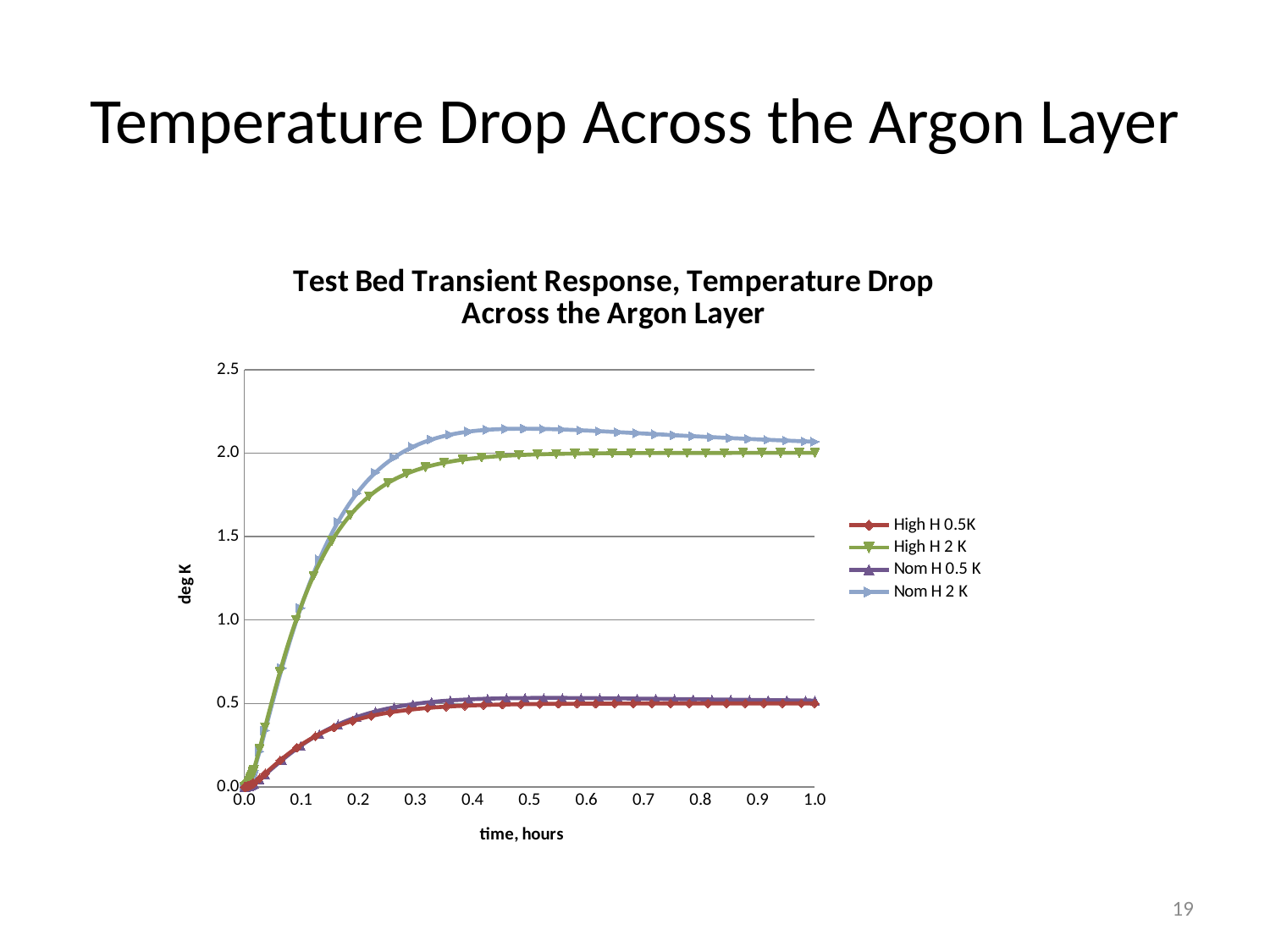
Is the value for Nom H 2 K at 0.1 hours greater or less than 1.5? less Is the value for High H 2 K at 0.2 hours greater or less than 1.5? greater At 0.5 hours, which series has the larger value, Nom H 2 K or High H 2 K? Nom H 2 K What kind of chart is shown on the slide? line chart How many series does the legend list? 4 What is the title of the chart? Test Bed Transient Response, Temperature Drop Across the Argon Layer How does the High H 2 K series change as time increases from 0.0 to 1.0 hours? rises then levels off What is the label on the x axis of the chart? time, hours Is the value for Nom H 2 K at 0.5 hours greater or less than 2.0? greater Which series reaches the highest value on the chart? Nom H 2 K